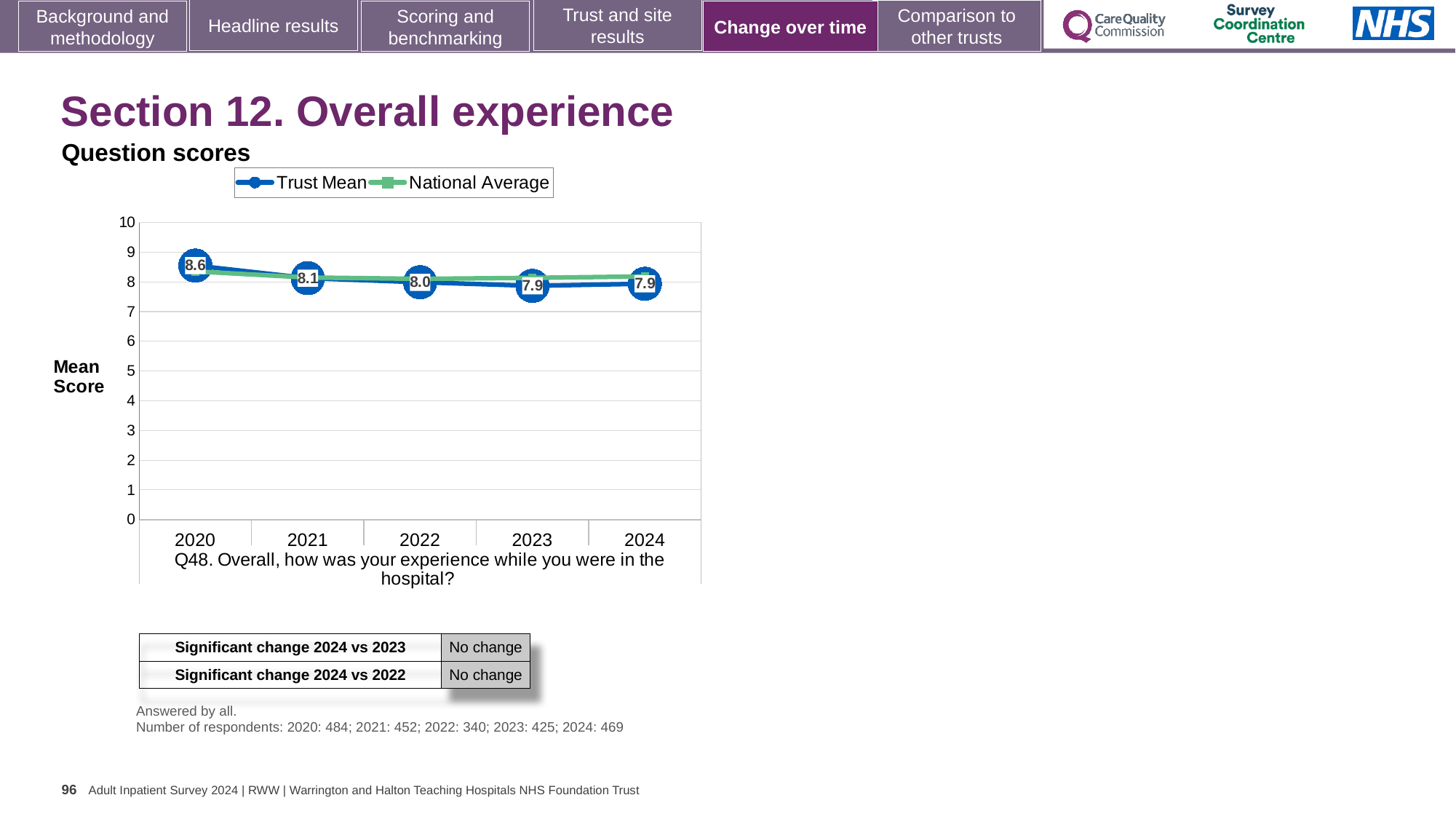
What is the difference between the Trust Mean score in 2020 and in 2024? 0.7 How many years are plotted on the x axis? 5 What kind of chart is shown? line chart How many series does the legend list? 2 Is the National Average value for 2024 greater or less than 7? greater What is the Trust Mean score for 2020? 8.6 What is the Trust Mean score for 2022? 8.0 Which year has the larger Trust Mean score, 2020 or 2021? 2020 In which year is the Trust Mean score highest? 2020 What is the Trust Mean score for 2021? 8.1 What is the Trust Mean score for 2024? 7.9 Does the Trust Mean score rise or fall from 2020 to 2024? fall